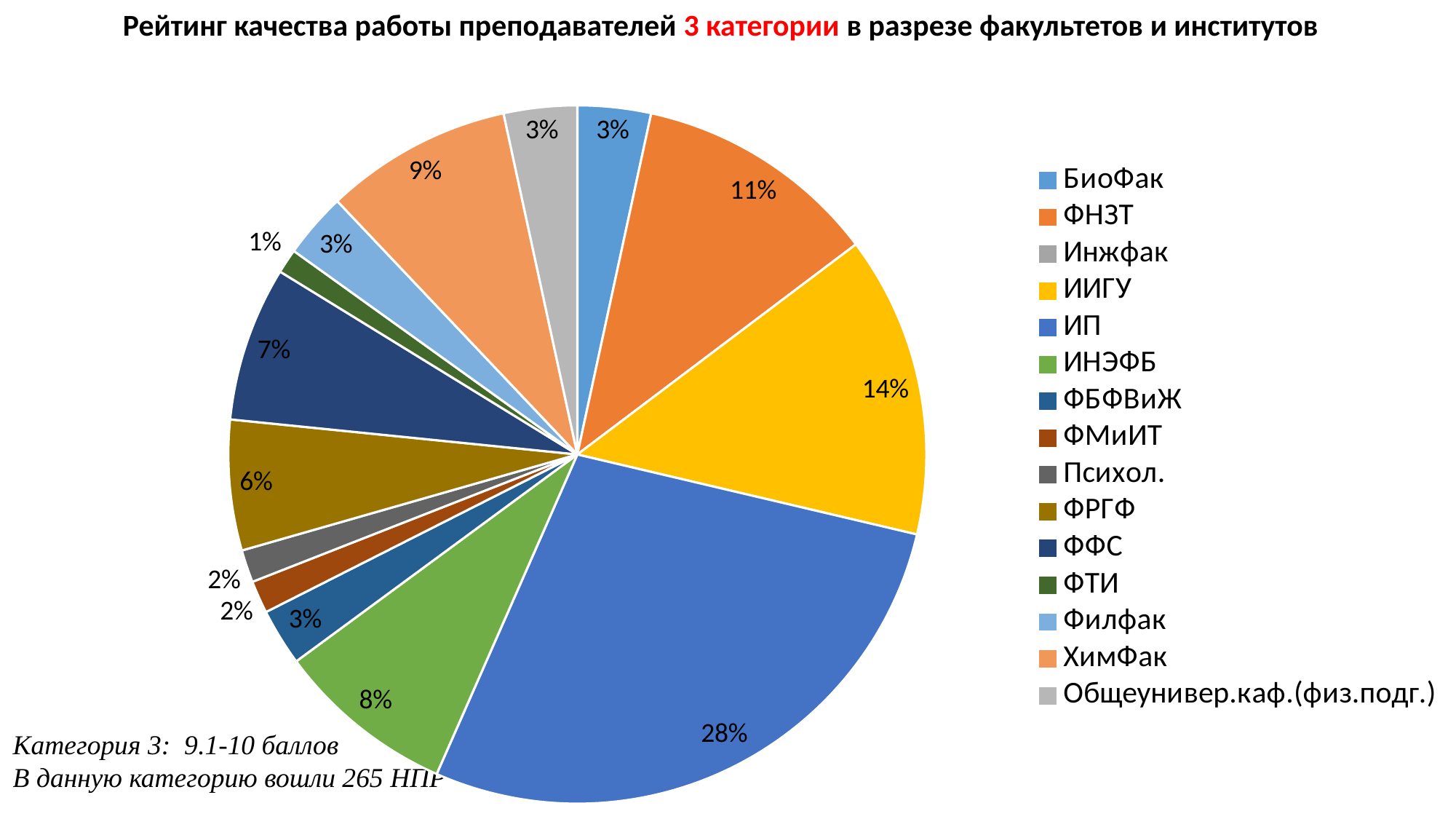
What share of the pie does ИП have? 28% What type of chart is shown on the slide? pie chart Which labelled slice has the smallest share of the pie? ФТИ What percentage is shown for ХимФак? 9% What percentage is shown for ИИГУ? 14% What is the difference in percentage points between ИП and ИИГУ? 14 How many entries does the legend list? 15 Which has a larger share, ИНЭФБ or ФРГФ? ИНЭФБ What is the title of the chart? Рейтинг качества работы преподавателей 3 категории в разрезе факультетов и институтов What percentage is shown for ФНЗТ? 11% Which category has the largest share of the pie? ИП What percentage is shown for ФФС? 7%